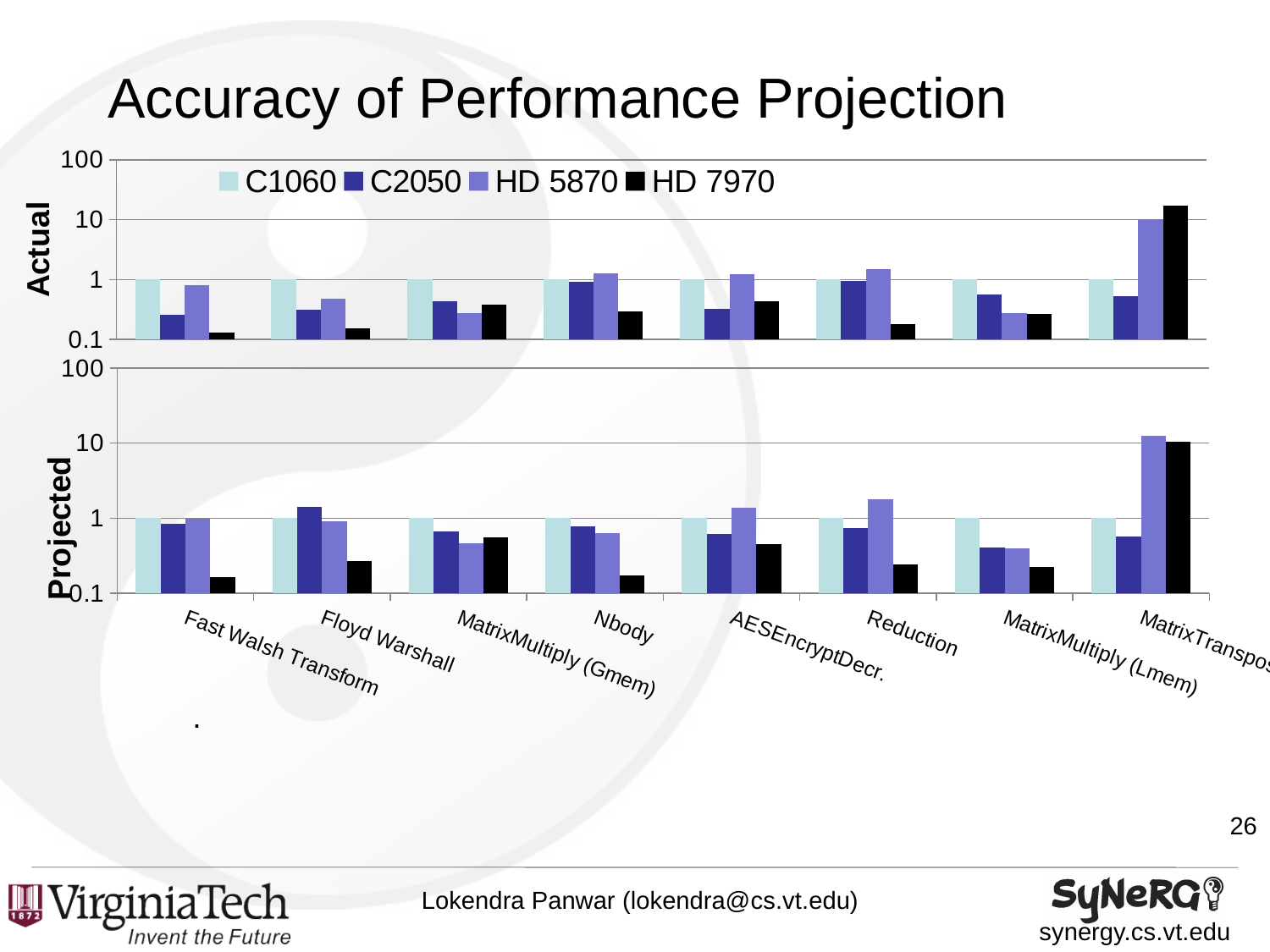
What kind of chart is the top (Actual) chart? bar chart How many series does the legend list? 4 In the bottom (Projected) chart, is the value for HD 5870 for Reduction greater or less than 1? greater How many benchmark categories are shown along the x axis of the bottom (Projected) chart? 8 In the top (Actual) chart, for Fast Walsh Transform, which is larger: HD 5870 or HD 7970? HD 5870 In the top (Actual) chart, is the value for HD 7970 for MatrixTranspose greater or less than 10? greater In the top (Actual) chart, is the value for HD 7970 for Fast Walsh Transform greater or less than 1? less What are the y-axis labels of the top and bottom charts? Actual and Projected In the top (Actual) chart, what is the value for C1060 for Nbody? 1 In the bottom (Projected) chart, which category has the highest HD 5870 value? MatrixTranspose In the top (Actual) chart, which category has the highest HD 7970 value? MatrixTranspose